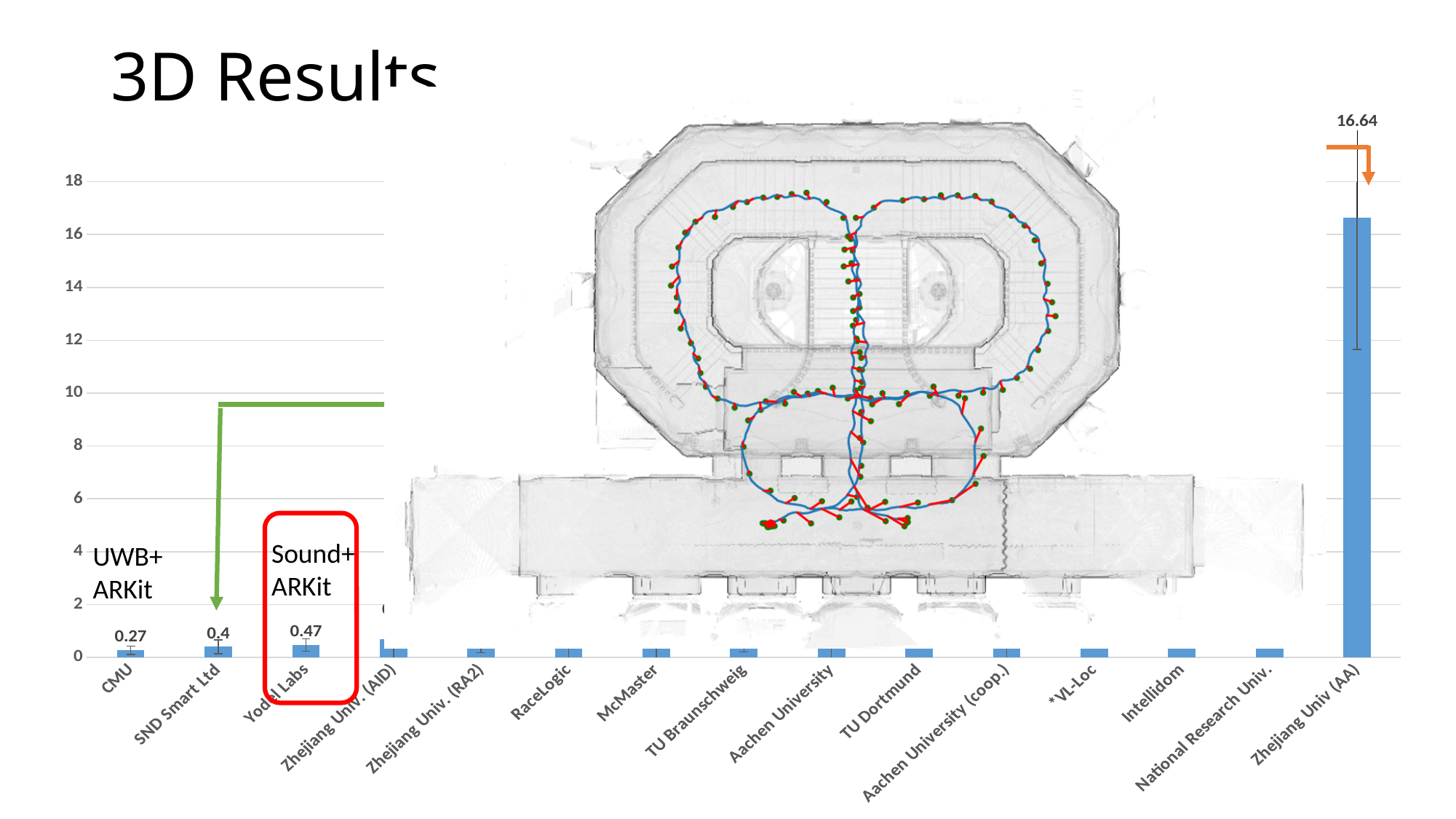
What kind of chart is shown on the slide? bar chart Which category is annotated with the label 'Sound+ARKit' in the red box? Yodel Labs What is the value for SND Smart Ltd? 0.4 How many categories are shown on the x axis? 15 Which category has the highest value? Zhejiang Univ (AA) What is the value for CMU? 0.27 What is the difference between the values for Yodel Labs and CMU? 0.2 Which is larger, the value for SND Smart Ltd or the value for Yodel Labs? Yodel Labs What is the difference between the values for Zhejiang Univ (AA) and CMU? 16.37 What is the value for Yodel Labs? 0.47 Is the value for Zhejiang Univ (AA) greater or less than 16? greater What is the value for Zhejiang Univ (AA)? 16.64